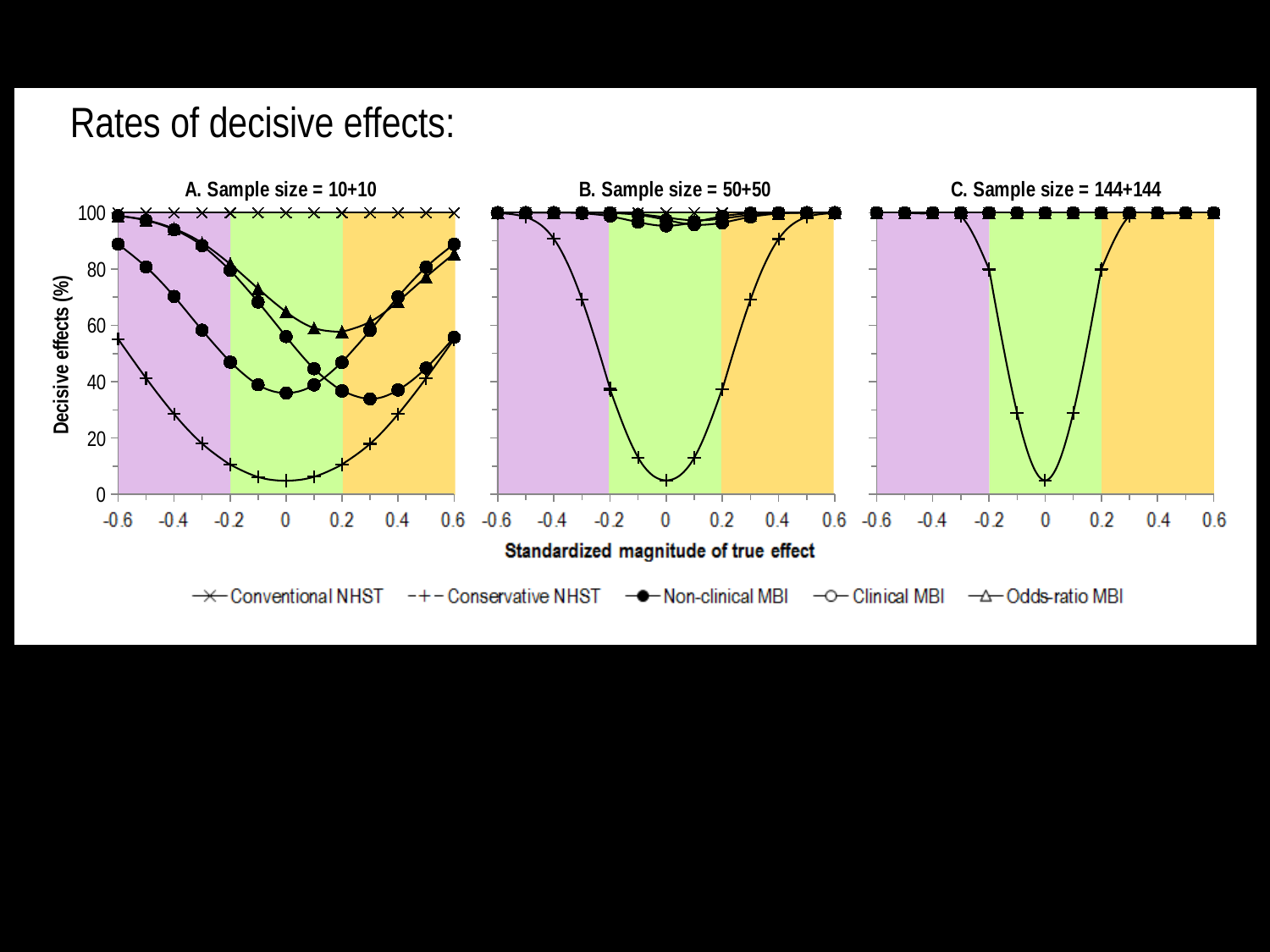
In panel B (Sample size = 50+50), is the value for Conservative NHST at a true effect of -0.4 greater or less than 80? greater In panel A (Sample size = 10+10), is the value for Odds-ratio MBI at a true effect of 0.2 greater or less than 80? less What kind of chart is shown in panel A (Sample size = 10+10)? line chart How many chart panels are on the slide? 3 In panel A (Sample size = 10+10), is the value for Conservative NHST at a true effect of 0 greater or less than 20? less In panel A (Sample size = 10+10), which series has the lowest value at a true effect of 0? Conservative NHST How many series does the shared legend list? 5 In panel A (Sample size = 10+10), does the Conservative NHST line rise or fall as the true effect goes from -0.6 to 0? fall What is the label of the y axis shared by the three panels? Decisive effects (%) In panel C (Sample size = 144+144), does the Conservative NHST line rise or fall as the true effect goes from 0 to 0.6? rise In panel A (Sample size = 10+10), at a true effect of -0.6, which is higher: Conservative NHST or Non-clinical MBI? Non-clinical MBI